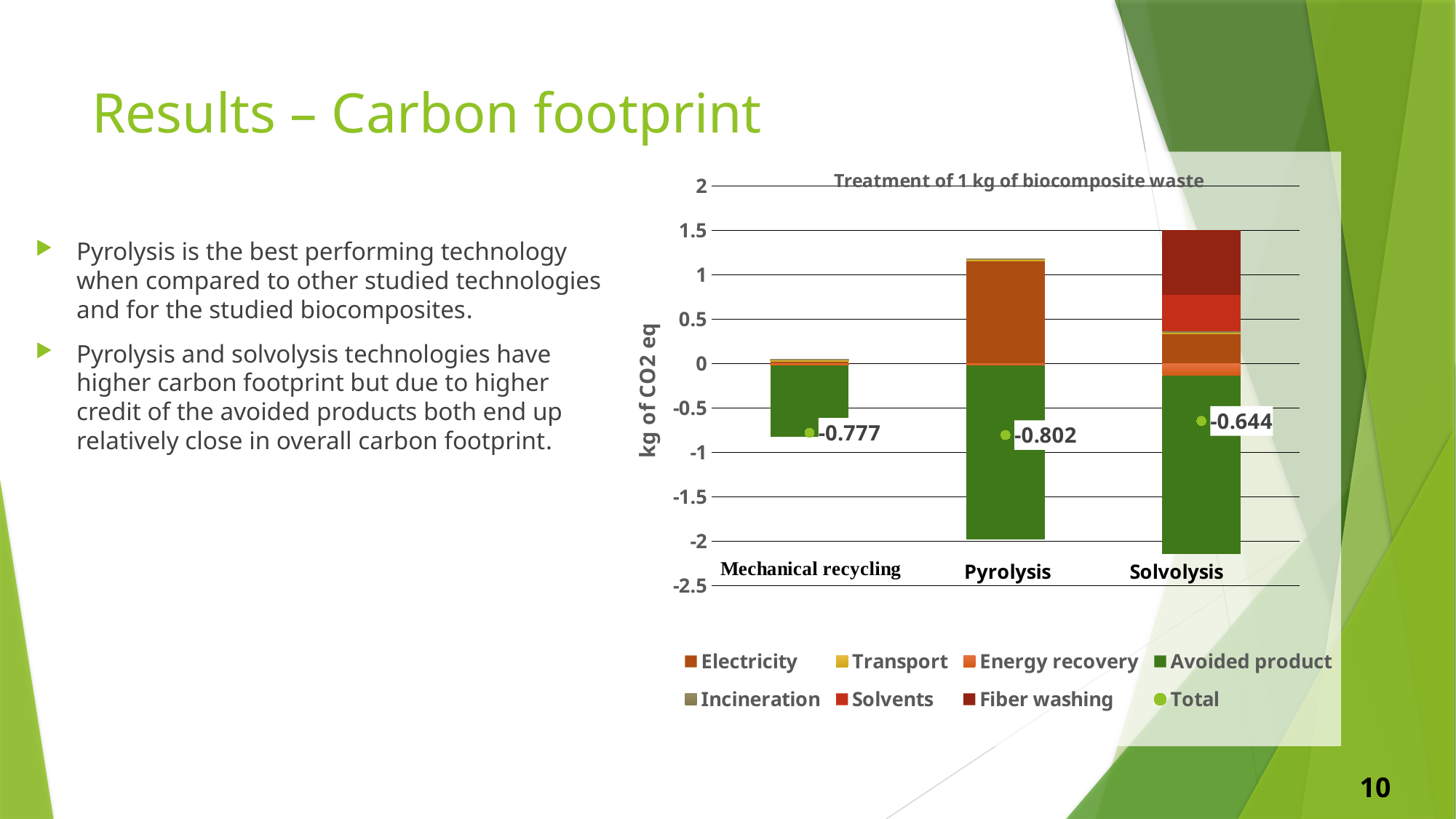
What is the y-axis title of the chart? kg of CO2 eq What is the Total value shown for Mechanical recycling? -0.777 How many treatment categories are shown on the x axis? 3 Which treatment has the highest Total value? Solvolysis What is the difference between the Total values for Solvolysis and Pyrolysis? 0.158 Which has the larger Total value, Mechanical recycling or Solvolysis? Solvolysis Which treatment has the lowest Total value? Pyrolysis Is the Avoided product value for Mechanical recycling greater or less than -1? greater Is the Avoided product value for Pyrolysis greater or less than -1.5? less What is the Total value shown for Pyrolysis? -0.802 How many series does the legend list? 8 What is the Total value shown for Solvolysis? -0.644